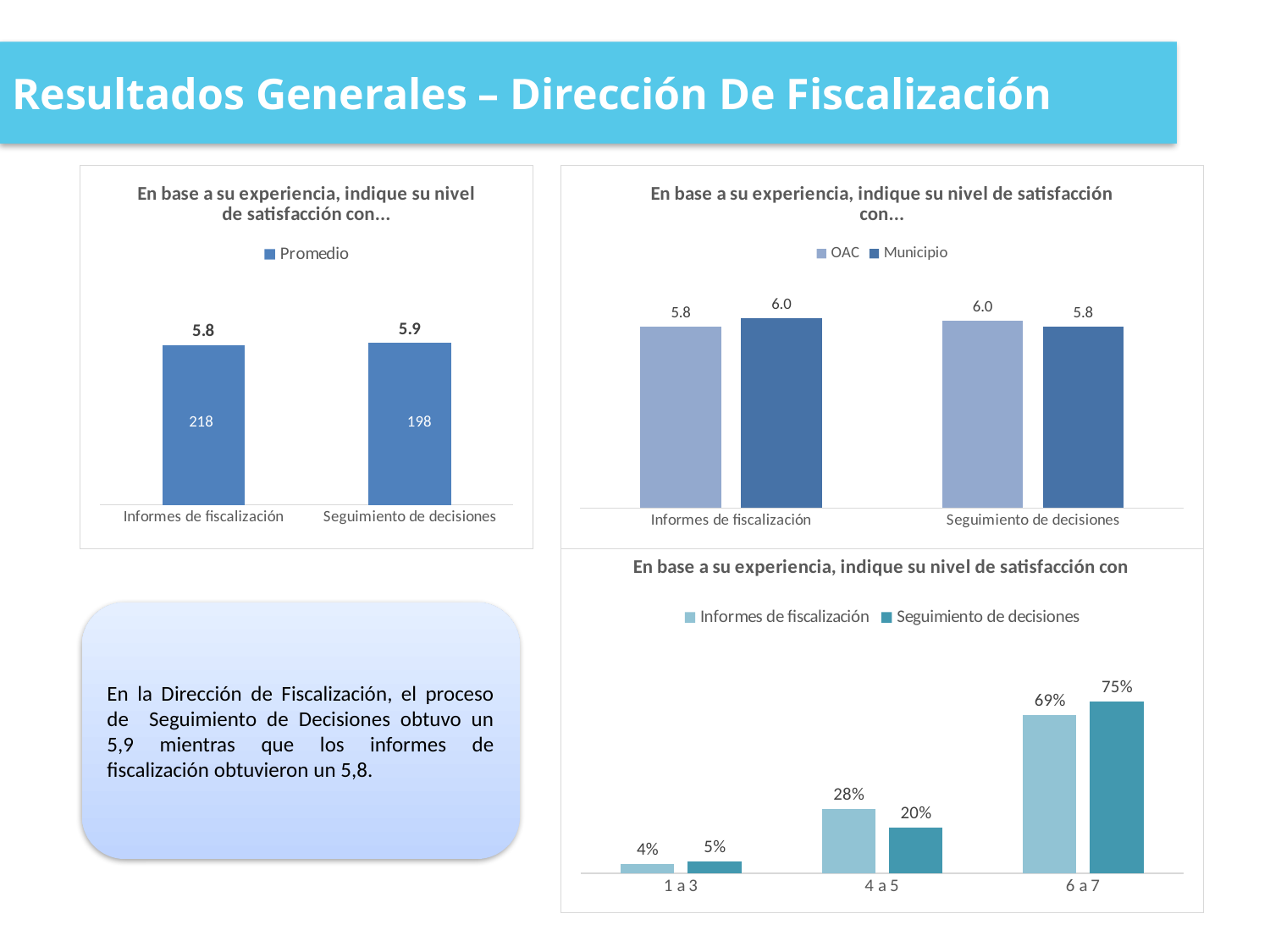
In the bottom-right chart, what percentage of Seguimiento de decisiones falls in the 6 a 7 range? 75% How many series does the legend of the top-right chart list? 2 In the top-right chart, what is the Municipio value for Informes de fiscalización? 6.0 In the top-right chart, what is the OAC value for Seguimiento de decisiones? 6.0 In the bottom-right chart, what percentage of Informes de fiscalización falls in the 4 a 5 range? 28% In the top-left chart, what is the Promedio value for Seguimiento de decisiones? 5.9 In the bottom-right chart, which range has the lowest value for Informes de fiscalización? 1 a 3 In the top-left chart, what number is printed inside the bar for Informes de fiscalización? 218 In the bottom-right chart, what is the difference between Seguimiento de decisiones and Informes de fiscalización in the 6 a 7 range? 6% In the top-left chart, which category has the higher Promedio value? Seguimiento de decisiones What type of chart is the bottom-right chart? Bar chart How many categories are shown on the x axis of the bottom-right chart? 3